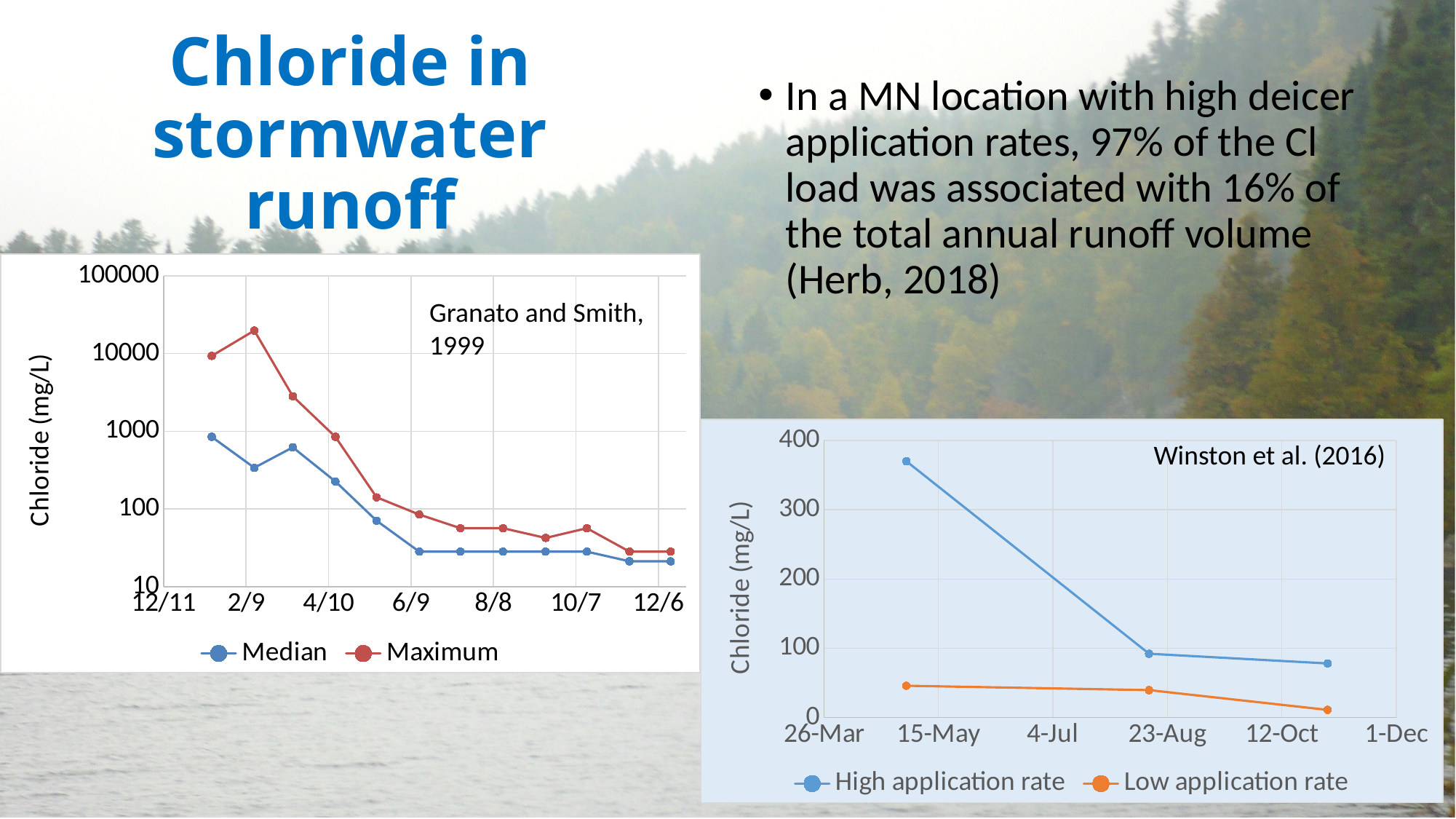
In the Winston et al. (2016) chart, is the first High application rate value greater or less than 300? greater In the Granato and Smith, 1999 chart, which series is higher at 4/10, Median or Maximum? Maximum In the Granato and Smith, 1999 chart, is the Maximum value at 2/9 greater or less than 10000? greater In the Granato and Smith, 1999 chart, is the Median value at 2/9 greater or less than 1000? less What kind of chart is the Granato and Smith, 1999 chart on the left? line chart How many data points does the High application rate series have in the Winston et al. (2016) chart? 3 In the Granato and Smith, 1999 chart, at which x-axis date does the Maximum series reach its highest value? 2/9 What is the y-axis label of the Winston et al. (2016) chart on the right? Chloride (mg/L) How many series does the legend of the Winston et al. (2016) chart list? 2 How many series does the legend of the Granato and Smith, 1999 chart list? 2 In the Granato and Smith, 1999 chart, do the Maximum values generally rise or fall from 2/9 to 12/6? fall In the Winston et al. (2016) chart, does the High application rate series rise or fall over time? fall